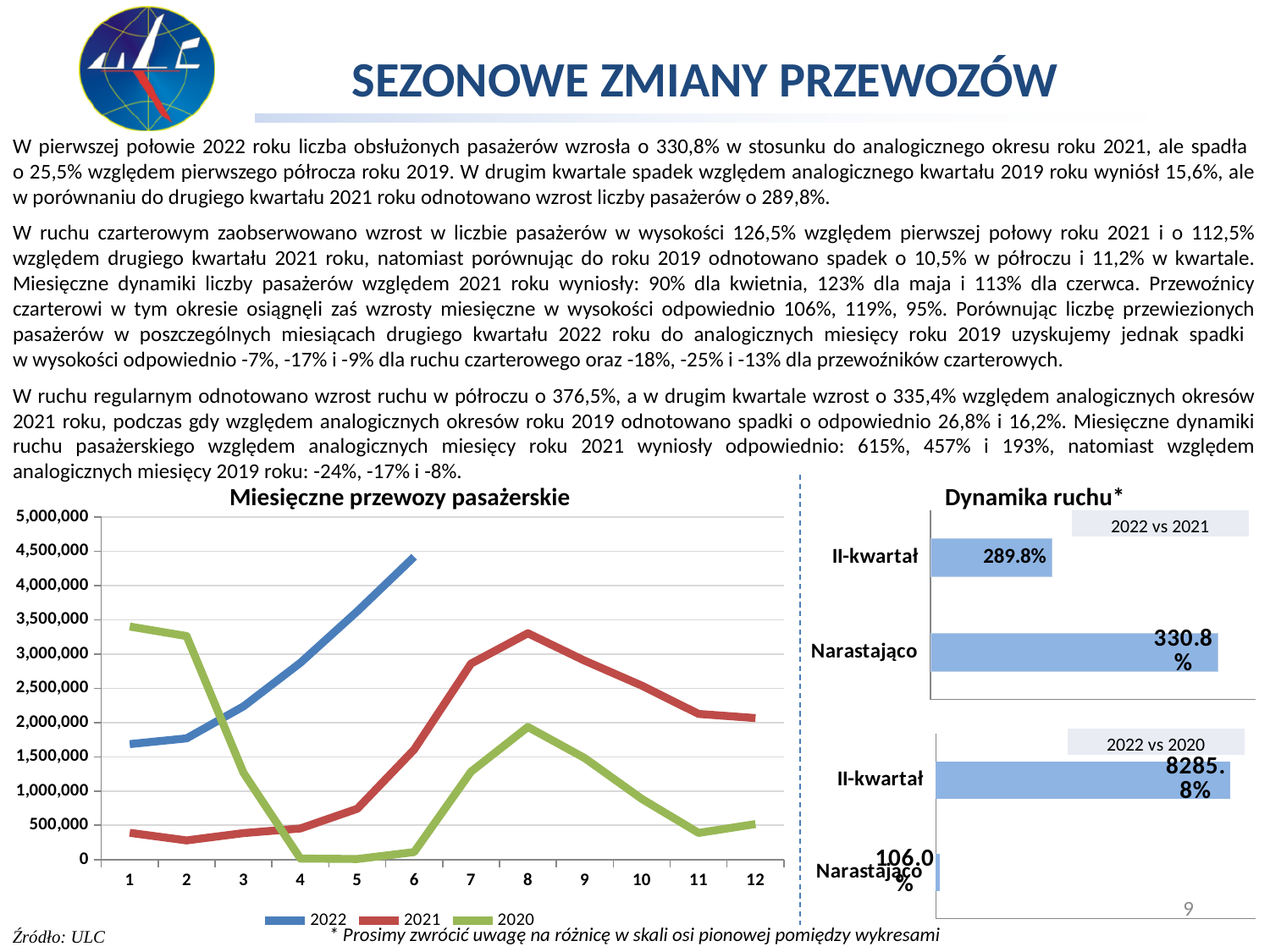
In the 'Dynamika ruchu' chart for 2022 vs 2021, what is the value for II-kwartał? 289.8% How many months are shown on the x axis of 'Miesięczne przewozy pasażerskie'? 12 In the 'Dynamika ruchu' chart for 2022 vs 2021, what is the difference between Narastająco and II-kwartał? 41.0% What kind of chart is 'Miesięczne przewozy pasażerskie'? line chart How many series does the legend of 'Miesięczne przewozy pasażerskie' list? 3 In 'Miesięczne przewozy pasażerskie', does the 2022 series rise or fall from month 1 to month 6? rise In 'Miesięczne przewozy pasażerskie', is the 2022 value for month 6 greater or less than 4,000,000? greater In 'Miesięczne przewozy pasażerskie', is the 2020 value for month 4 greater or less than 500,000? less In the 'Dynamika ruchu' chart for 2022 vs 2020, what is the value for II-kwartał? 8285.8% In the 'Dynamika ruchu' chart for 2022 vs 2021, what is the value for Narastająco? 330.8% In 'Miesięczne przewozy pasażerskie', which series has the larger value at month 1, 2020 or 2021? 2020 In 'Miesięczne przewozy pasażerskie', in which month does the 2021 series reach its highest value? 8